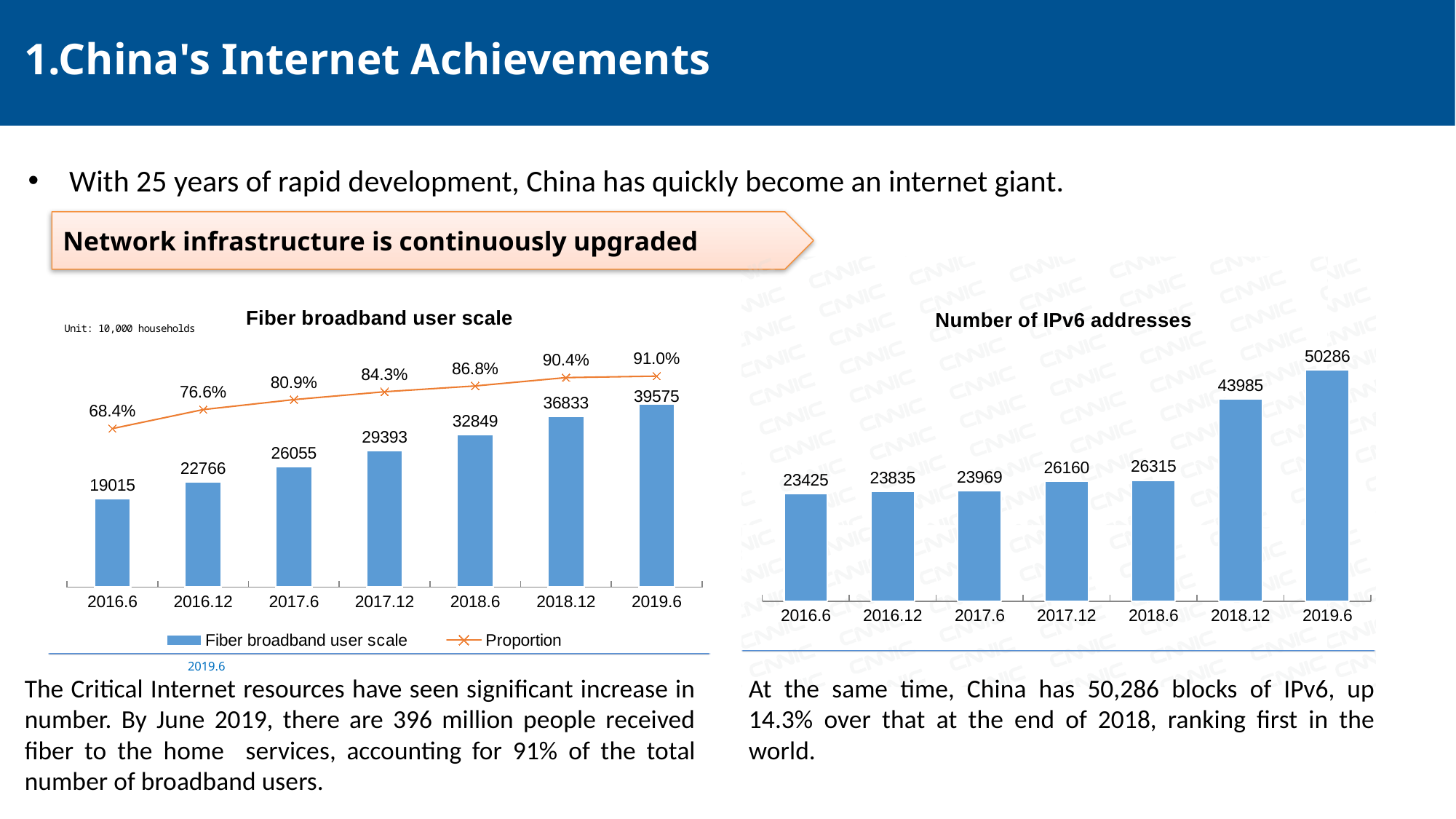
In the 'Fiber broadband user scale' chart, what unit is stated for the data? 10,000 households In the 'Number of IPv6 addresses' chart, how many periods are shown on the x axis? 7 In the 'Number of IPv6 addresses' chart, which period has the highest value? 2019.6 In the 'Fiber broadband user scale' chart, what is the Proportion value for 2018.6? 86.8% In the 'Fiber broadband user scale' chart, does the Proportion line rise or fall from 2016.6 to 2019.6? rise In the 'Fiber broadband user scale' chart, how many series does the legend list? 2 In the 'Fiber broadband user scale' chart, what is the difference in fiber broadband user scale between 2019.6 and 2018.12? 2742 In the 'Fiber broadband user scale' chart, which period has the lowest fiber broadband user scale? 2016.6 What kind of chart is the 'Number of IPv6 addresses' chart? bar chart In the 'Number of IPv6 addresses' chart, what is the difference between the values for 2019.6 and 2018.12? 6301 In the 'Number of IPv6 addresses' chart, what is the value for 2017.12? 26160 In the 'Fiber broadband user scale' chart, what is the fiber broadband user scale for 2017.12? 29393